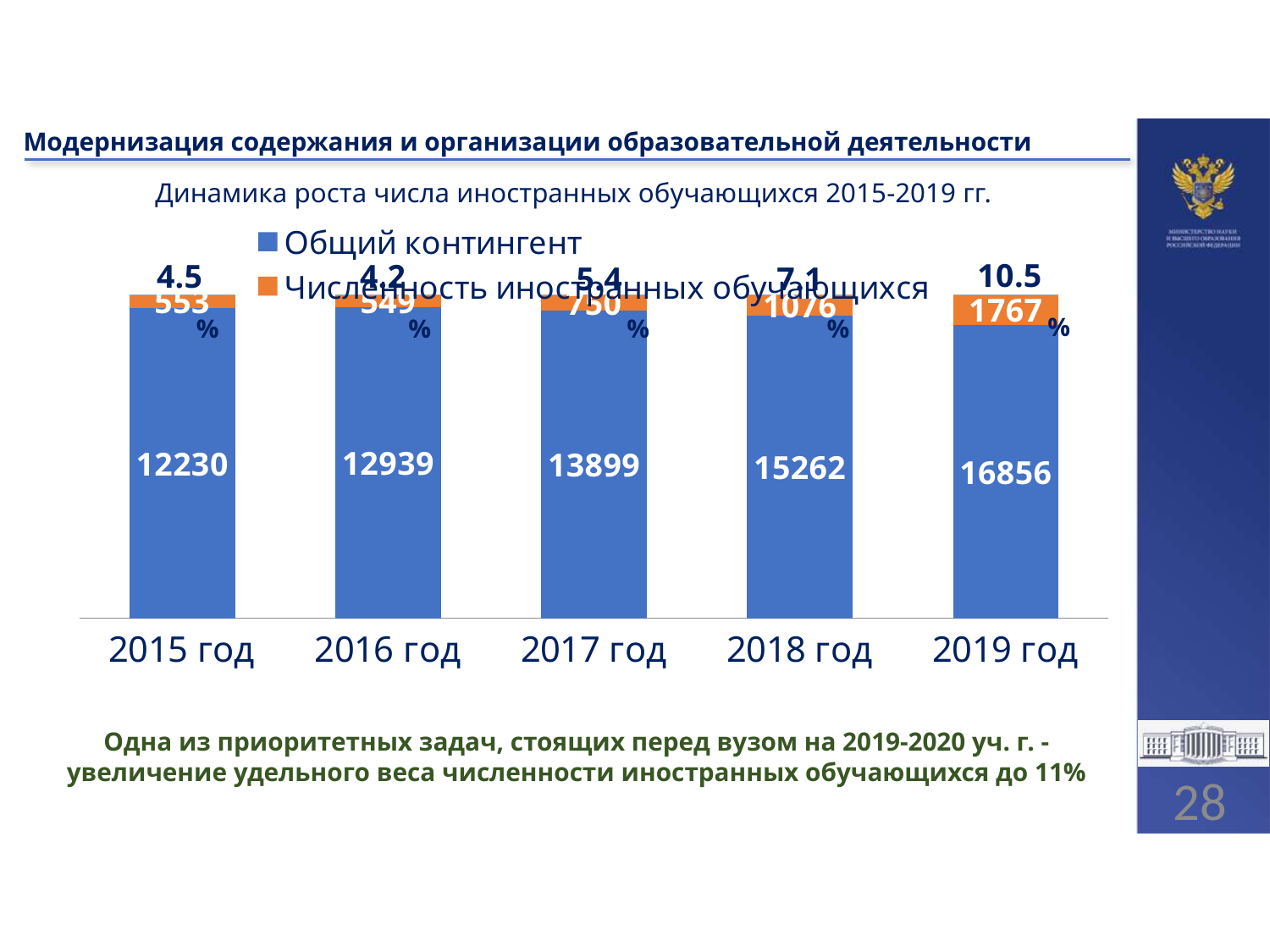
What is the value of 'Численность иностранных обучающихся' for 2019 год? 1767 What type of chart is shown on the slide? bar chart What is the value of 'Общий контингент' for 2019 год? 16856 Which year has the highest value for 'Общий контингент'? 2019 год Which year has the lowest value for 'Общий контингент'? 2015 год What is the difference between 'Общий контингент' in 2019 год and 2018 год? 1594 What is the value of 'Общий контингент' for 2015 год? 12230 How many series does the legend list? 2 Does the value of 'Общий контингент' rise or fall from 2015 год to 2019 год? rise What is the value of 'Численность иностранных обучающихся' for 2018 год? 1076 How many years (categories) are shown on the x axis? 5